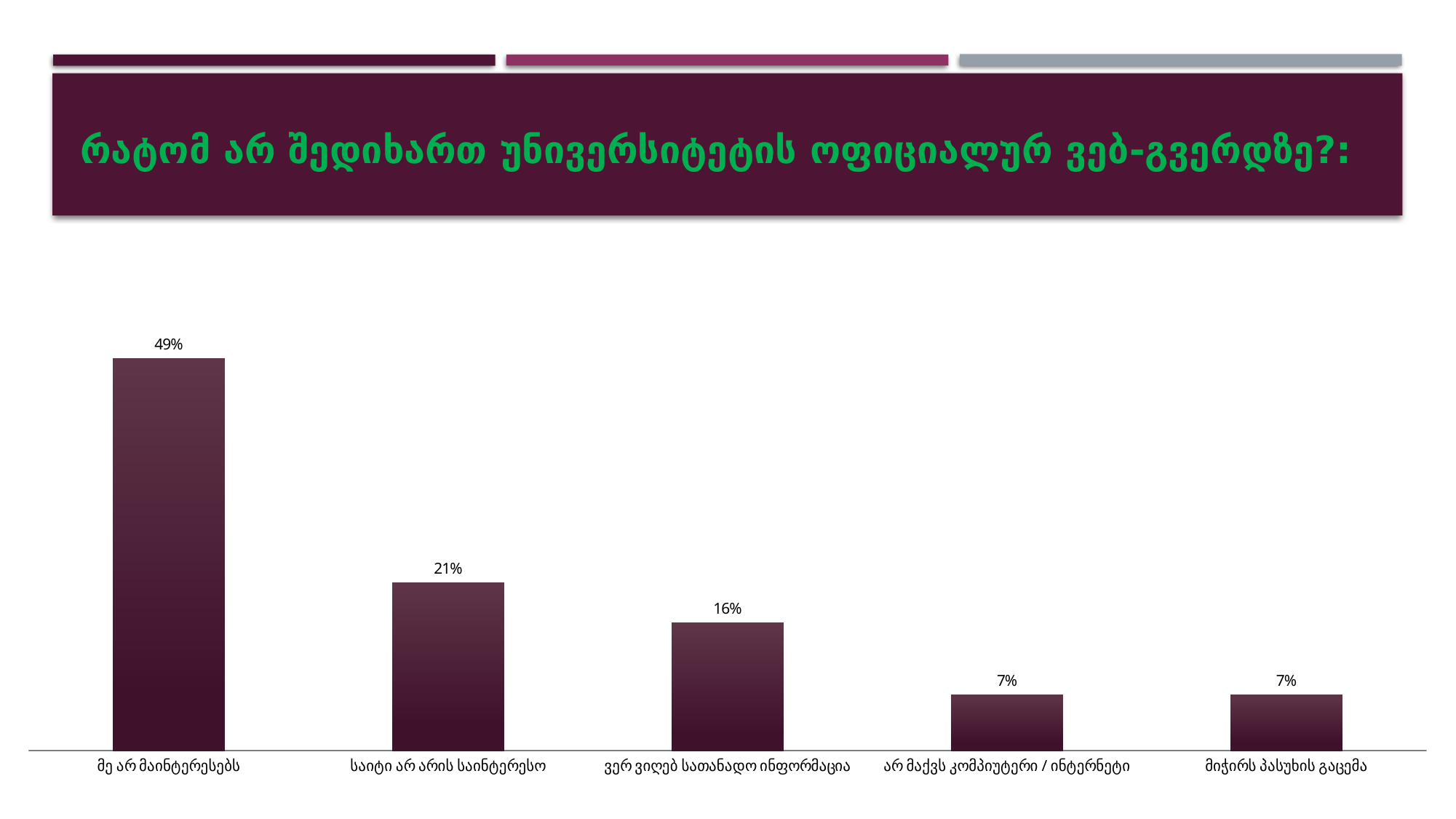
Which category has the highest value? მე არ მაინტერესებს How many categories are shown in the chart? 5 What value is shown for "არ მაქვს კომპიუტერი / ინტერნეტი"? 7% What is the difference between the values for "საიტი არ არის საინტერესო" and "ვერ ვიღებ სათანადო ინფორმაცია"? 5% Do the values rise or fall from left to right across the categories? Fall What value is shown for "ვერ ვიღებ სათანადო ინფორმაცია"? 16% What kind of chart is shown on the slide? Bar chart What value is shown for "საიტი არ არის საინტერესო"? 21% What value is shown for "მე არ მაინტერესებს"? 49% What is the difference between the values for "მე არ მაინტერესებს" and "საიტი არ არის საინტერესო"? 28% What is the title of the slide? რატომ არ შედიხართ უნივერსიტეტის ოფიციალურ ვებ-გვერდზე?: Which is larger, the value for "ვერ ვიღებ სათანადო ინფორმაცია" or the value for "მიჭირს პასუხის გაცემა"? ვერ ვიღებ სათანადო ინფორმაცია